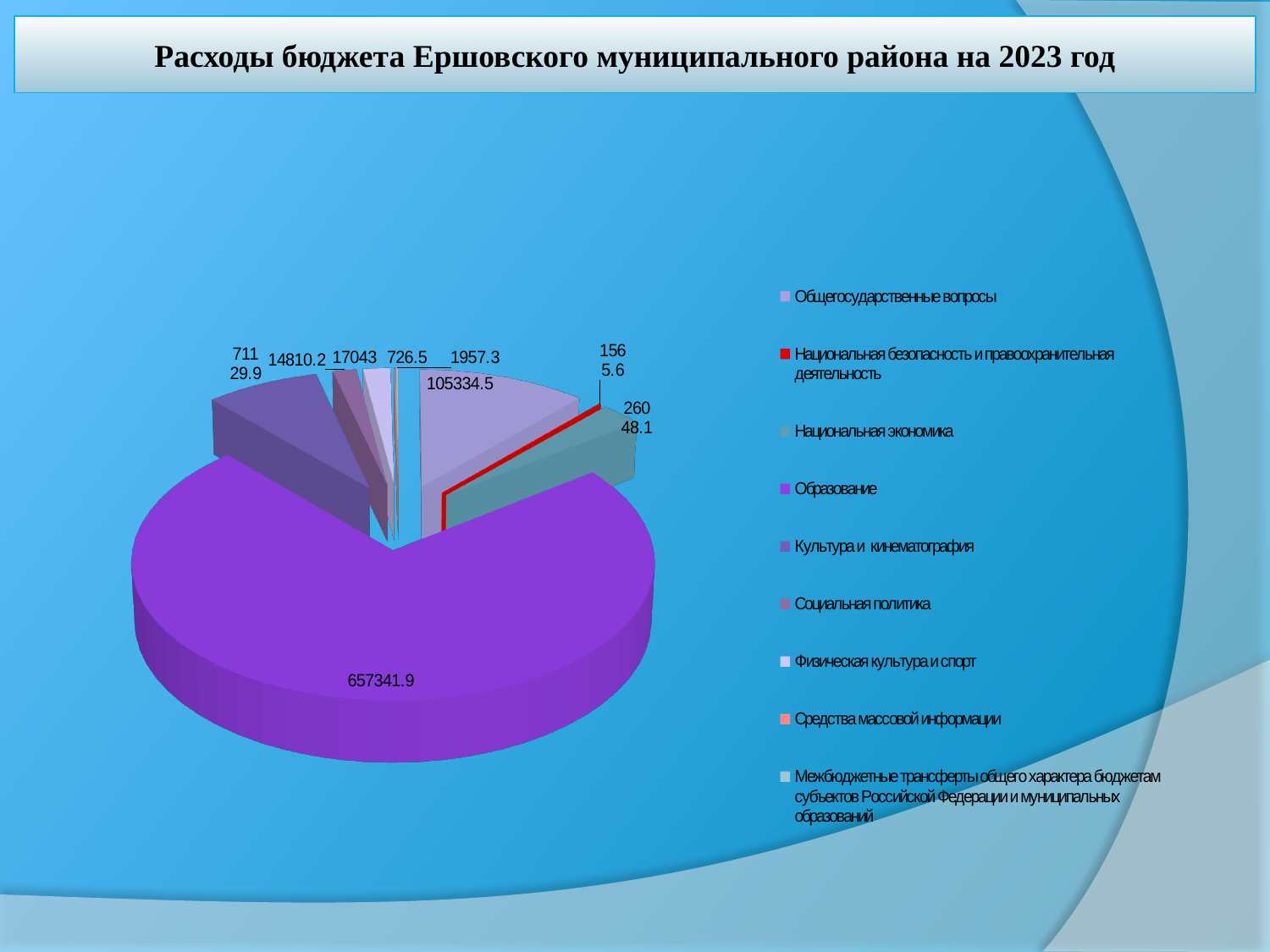
What kind of chart is shown on the slide? Pie chart What is the value shown for Межбюджетные трансферты общего характера бюджетам субъектов Российской Федерации и муниципальных образований? 1957.3 Which category has the largest slice of the pie chart? Образование What is the value shown for Средства массовой информации? 726.5 What is the difference between the values for Физическая культура и спорт and Социальная политика? 2232.8 How many categories does the legend of the pie chart list? 9 What is the value shown for Образование? 657341.9 What is the value shown for Физическая культура и спорт? 17043 Which category has the smallest value in the pie chart? Средства массовой информации What is the value shown for Социальная политика? 14810.2 What is the title of the chart on the slide? Расходы бюджета Ершовского муниципального района на 2023 год What is the value shown for Общегосударственные вопросы? 105334.5